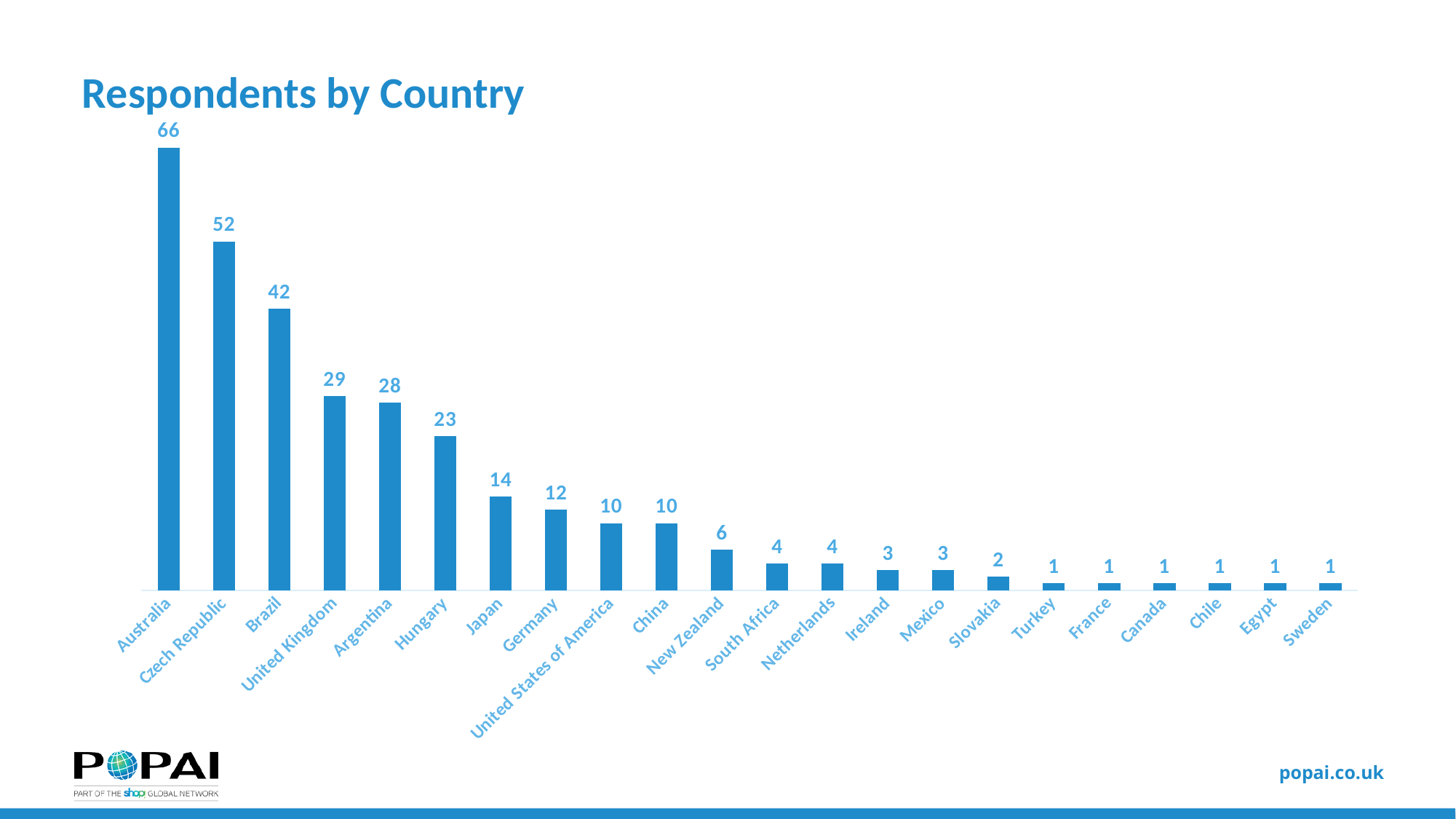
What is the difference between the values for Brazil and Japan? 28 What kind of chart is shown on the slide? Bar chart How many respondents are shown for the United Kingdom? 29 Which has a larger value, Argentina or Hungary? Argentina What is the difference between the values for Australia and Czech Republic? 14 Which country has the highest number of respondents? Australia Which has a larger value, Germany or China? Germany What is the value for Hungary? 23 What is the value for New Zealand? 6 How many countries are shown on the chart? 22 What is the value for Australia? 66 What is the title of the chart? Respondents by Country